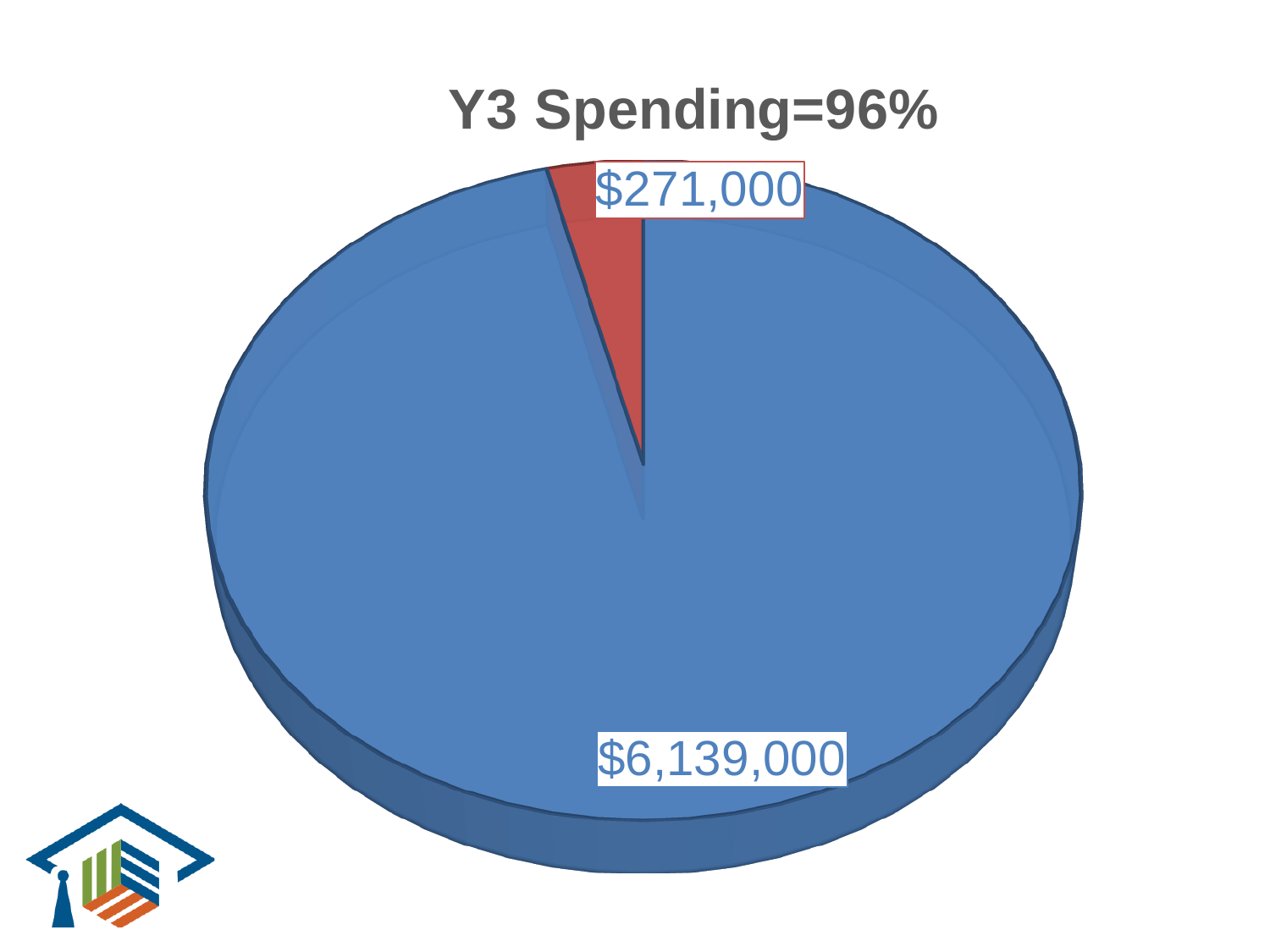
What is the total of the two slice values in the pie chart? $6,410,000 What value is labelled on the blue slice of the pie chart? $6,139,000 Which slice of the pie chart is the largest? the blue slice ($6,139,000) What value is labelled on the red slice of the pie chart? $271,000 What is the difference between the blue slice value and the red slice value? $5,868,000 Which is larger, the blue slice or the red slice? the blue slice What is the title of the chart? Y3 Spending=96% Which slice of the pie chart is the smallest? the red slice ($271,000) How many slices does the pie chart have? 2 What kind of chart is shown on the slide? pie chart Approximately what percentage of the pie does the blue slice represent, as stated in the chart title? 96% What colour is the smaller slice of the pie chart? red